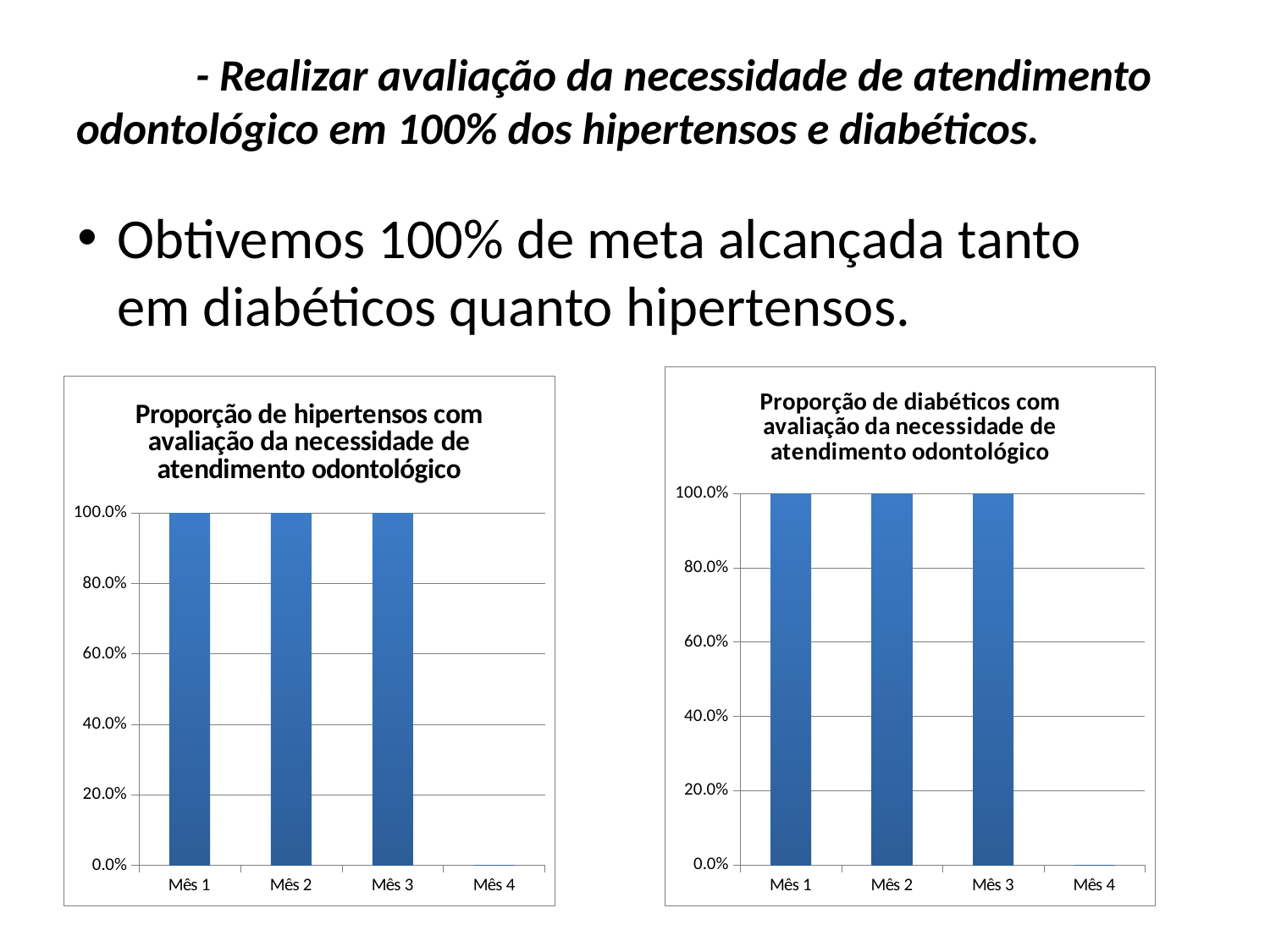
In the chart titled 'Proporção de diabéticos com avaliação da necessidade de atendimento odontológico', what is the value for Mês 3? 100.0% In the chart titled 'Proporção de hipertensos com avaliação da necessidade de atendimento odontológico', what is the value for Mês 1? 100.0% In the right chart (diabéticos), is the value for Mês 4 greater or less than 20.0%? less In the left chart (hipertensos), which month has the lowest value? Mês 4 In the left chart (hipertensos), is the value for Mês 3 greater or less than 80.0%? greater In the left chart (hipertensos), what is the value for Mês 2? 100.0% How many months are shown on the x axis of the left chart (hipertensos)? 4 What kind of chart is the right chart (diabéticos)? Bar chart What is the title of the right chart? Proporção de diabéticos com avaliação da necessidade de atendimento odontológico In the right chart (diabéticos), which is larger, the value for Mês 2 or the value for Mês 4? Mês 2 In the left chart (hipertensos), what is the difference between the values for Mês 1 and Mês 2? 0.0% In the right chart (diabéticos), which month has the lowest value? Mês 4